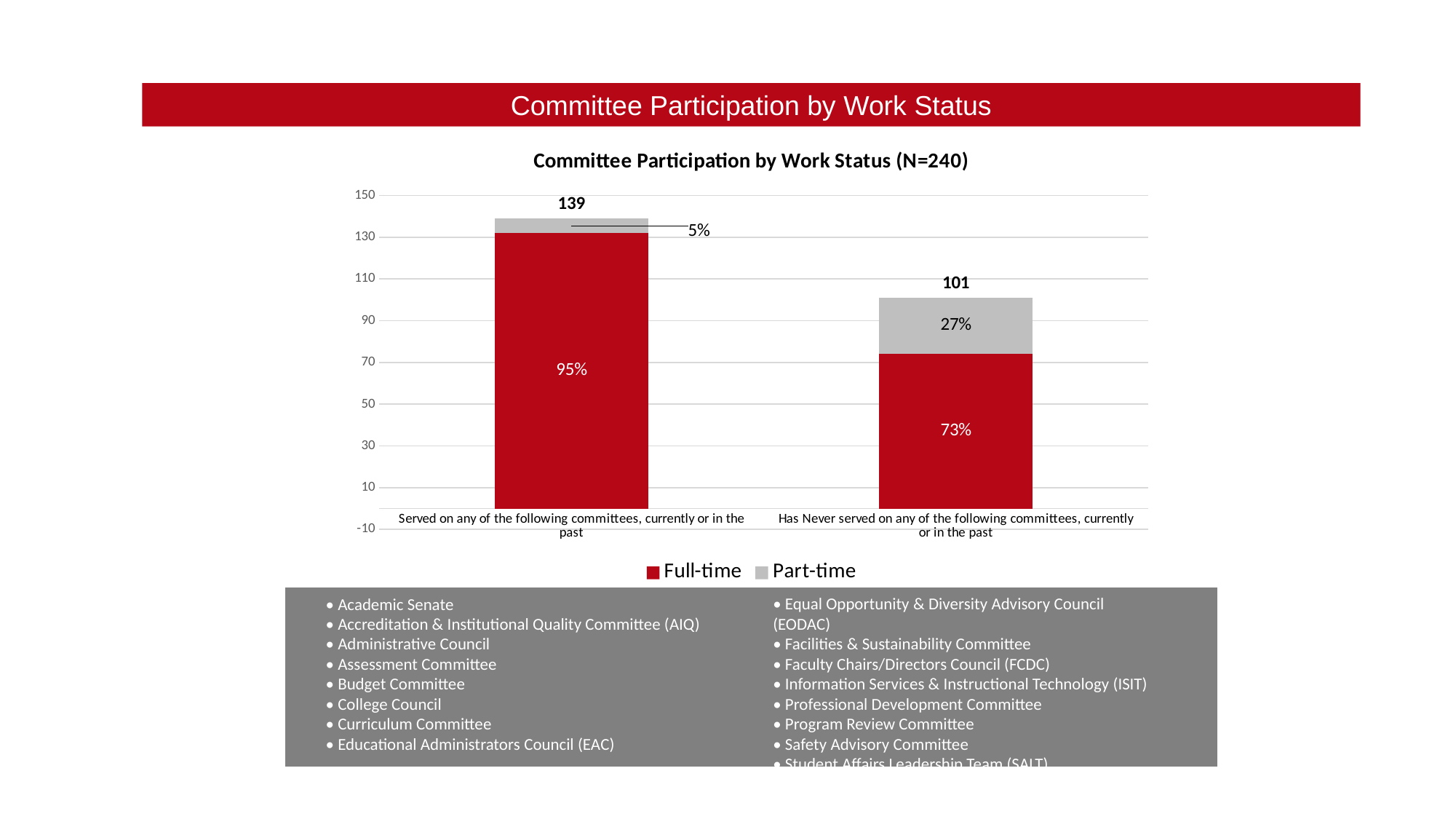
How many categories are shown on the x axis? 2 What percentage label is shown for the Part-time segment of the 'Served on any of the following committees' bar? 5% What percentage label is shown for the Part-time segment of the 'Has Never served on any of the following committees' bar? 27% How many series does the legend list? 2 What is the difference between the totals of the two bars (139 and 101)? 38 What kind of chart is shown on the slide? Stacked bar chart Which category has the higher total: 'Served on any of the following committees' or 'Has Never served on any of the following committees'? Served on any of the following committees, currently or in the past What percentage label is shown for the Full-time segment of the 'Served on any of the following committees' bar? 95% What percentage label is shown for the Full-time segment of the 'Has Never served on any of the following committees' bar? 73% What is the total shown above the bar for 'Served on any of the following committees, currently or in the past'? 139 What is the total shown above the bar for 'Has Never served on any of the following committees, currently or in the past'? 101 Which series is shown in red according to the legend? Full-time